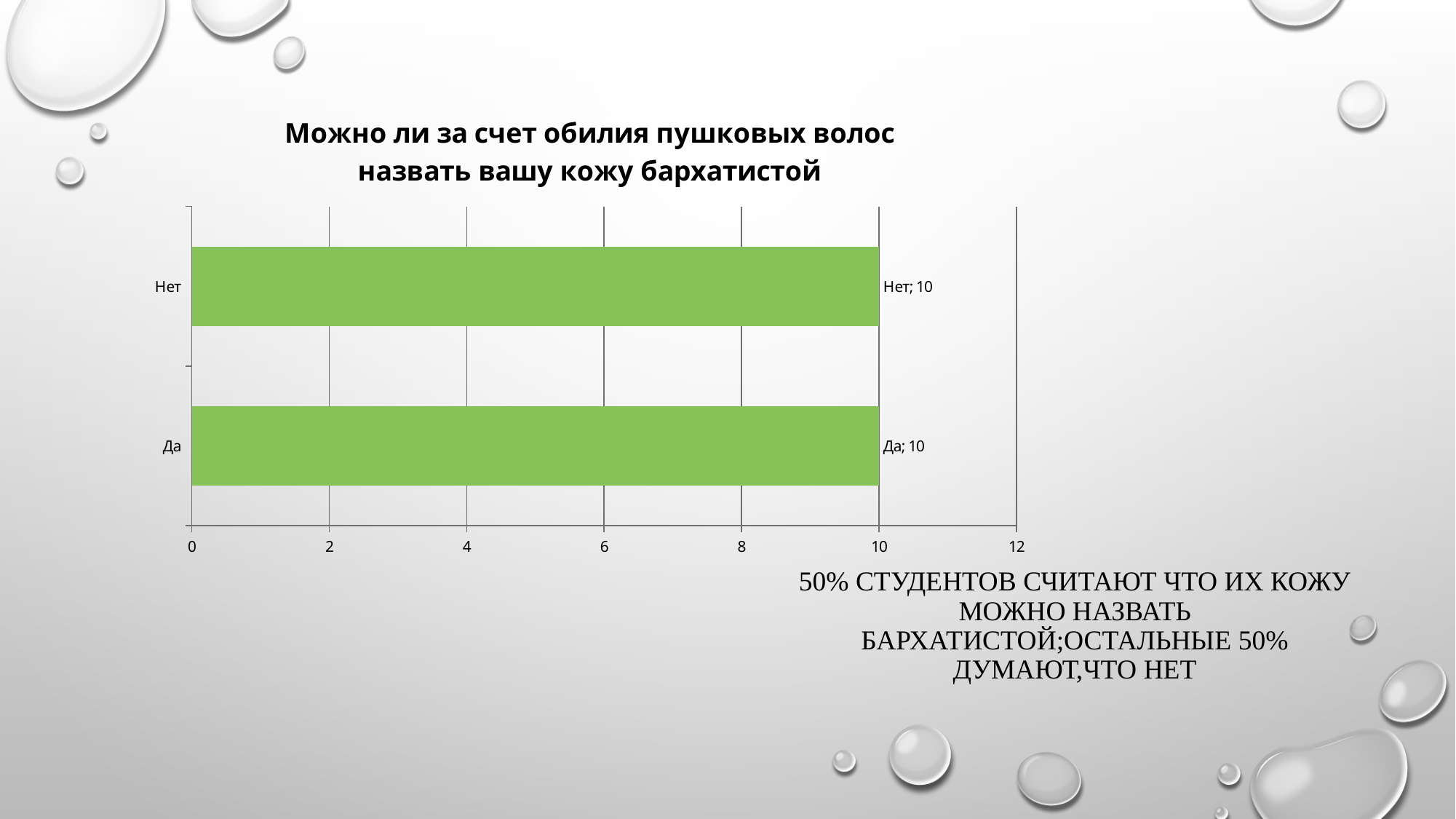
What is the value for "Да"? 10 What is the title of the chart? Можно ли за счет обилия пушковых волос назвать вашу кожу бархатистой What is the total of the values for "Да" and "Нет"? 20 How many categories are shown in the chart? 2 What is the value for "Нет"? 10 What is the maximum value shown on the horizontal axis? 12 What is the difference between the values for "Нет" and "Да"? 0 Is the value for "Нет" greater or less than 12? less What colour are the bars in the chart? green Is the value for "Да" greater or less than 8? greater What kind of chart is shown on the slide? bar chart